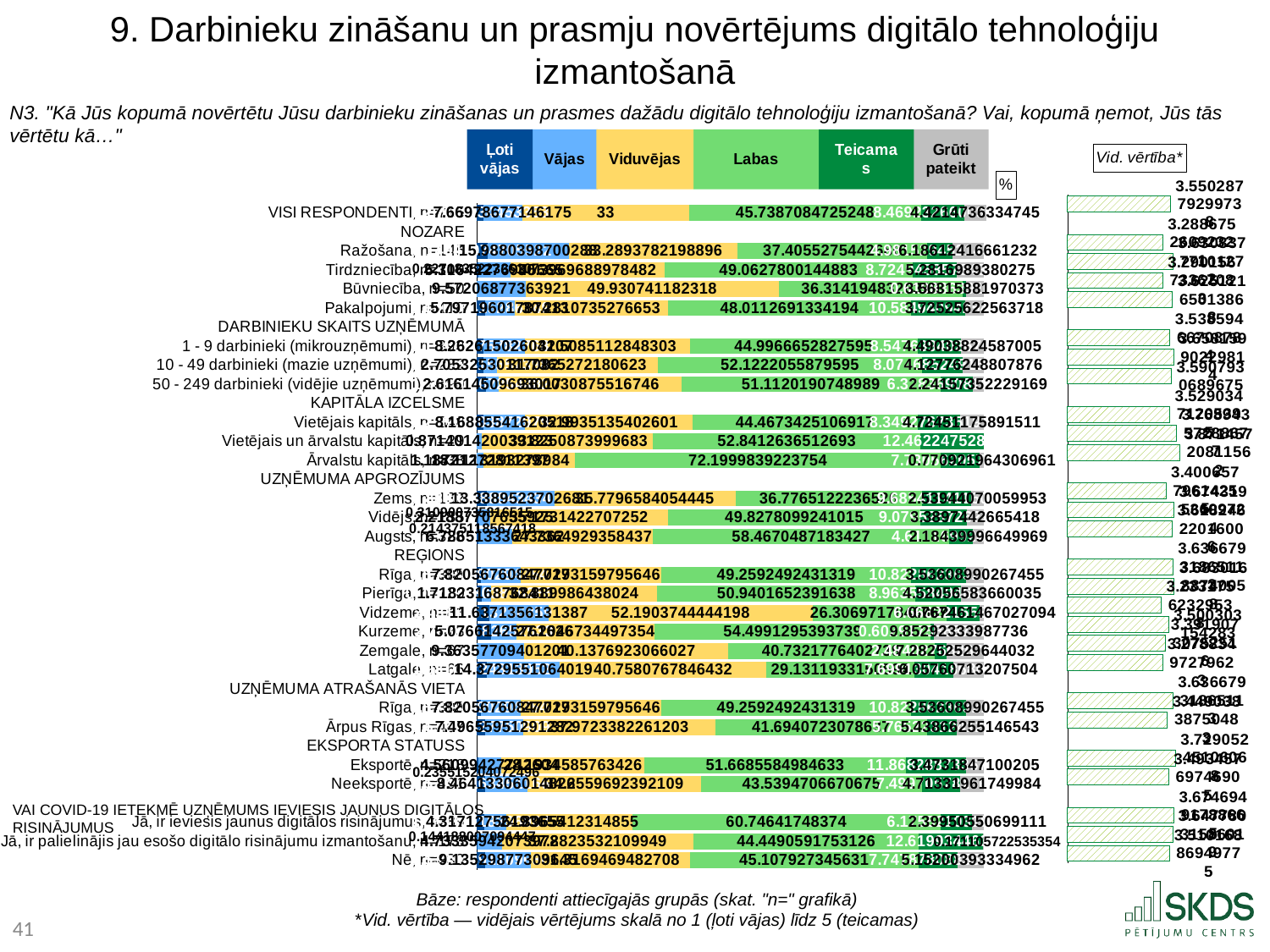
Which category has the largest "Labas" segment? Ārvalstu kapitāls What is the value of the "Labas" segment for "Jā, ir ieviesis jaunus digitālos risinājumus"? 60.74641748374 What is the value of the "Viduvējas" segment for "Vidzeme"? 52.1903744444198 How many series does the legend list? 6 What is the value of the "Viduvējas" segment for "VISI RESPONDENTI"? 33 Which has a larger "Labas" segment: "Ārvalstu kapitāls" or "Vietējais kapitāls"? Ārvalstu kapitāls What is the value of the "Labas" segment for "Eksportē"? 51.6685584984633 What is the value of the "Labas" segment for "Augsts" (uzņēmuma apgrozījums)? 58.4670487183427 What is the value of the "Labas" segment for "Ārvalstu kapitāls"? 72.1999839223754 What kind of chart is shown on the slide? bar chart What is the first entry in the chart legend? Ļoti vājas What is the value of the "Labas" segment for "Pierīga"? 50.9401652391638